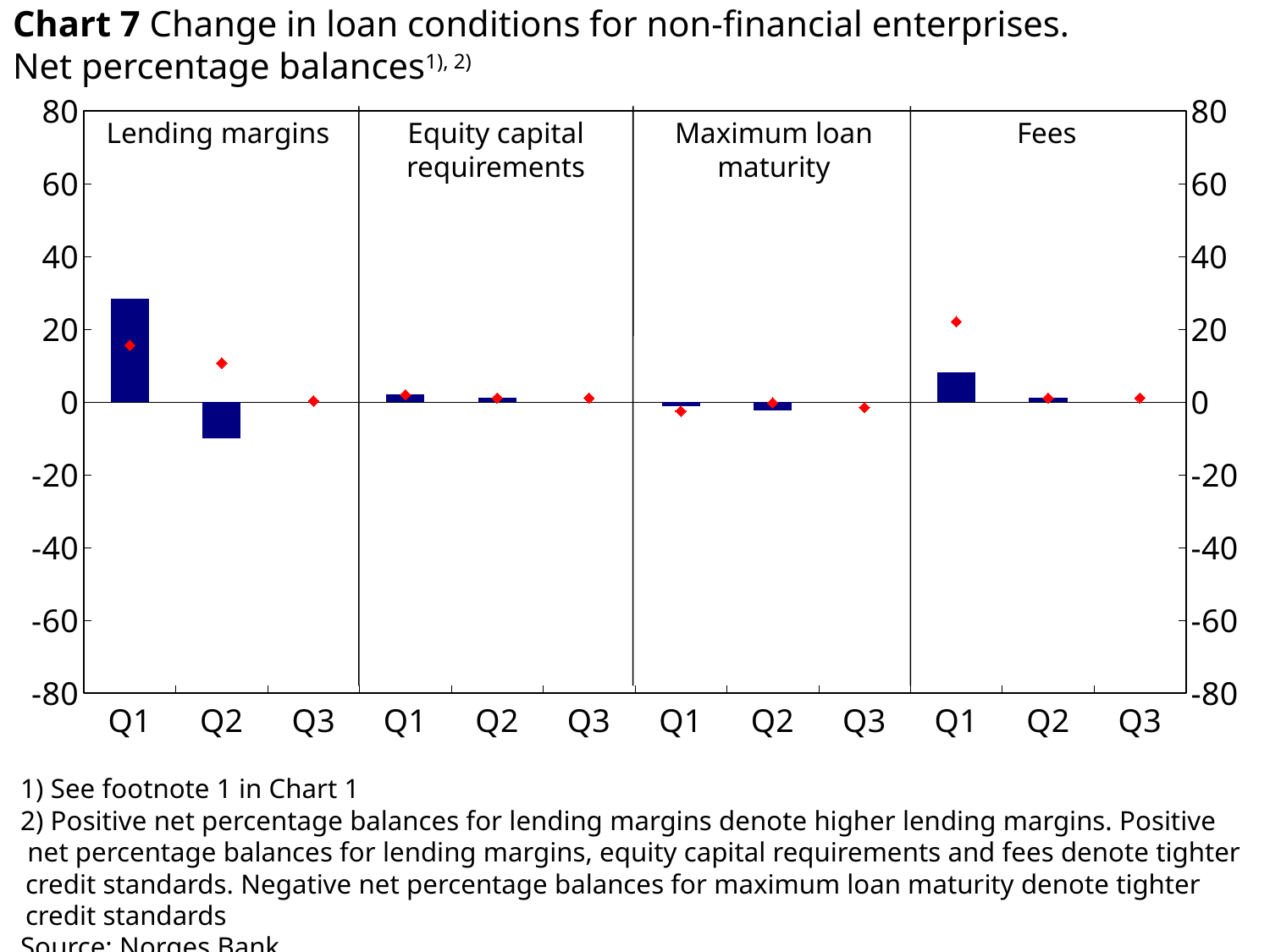
What is the title of the chart? Chart 7 Change in loan conditions for non-financial enterprises. Net percentage balances Is the Q2 bar in the Lending margins panel greater or less than 0? less How many loan condition panels does the chart show? 4 Is the Q1 bar in the Lending margins panel greater or less than 20? greater In the Lending margins panel, which quarter has the lowest bar? Q2 Is the Q1 bar in the Fees panel greater or less than 20? less Which is larger: the Q1 bar in the Lending margins panel or the Q1 bar in the Fees panel? Lending margins Q1 What kind of chart is shown on the slide? Combination bar and line chart (bars with red diamond markers) Which panel contains the highest bar in the whole chart? Lending margins In the Lending margins panel, which quarter has the tallest bar? Q1 How many quarters are shown in each panel of the chart? 3 Do the bars in the Fees panel rise or fall from Q1 to Q3? Fall